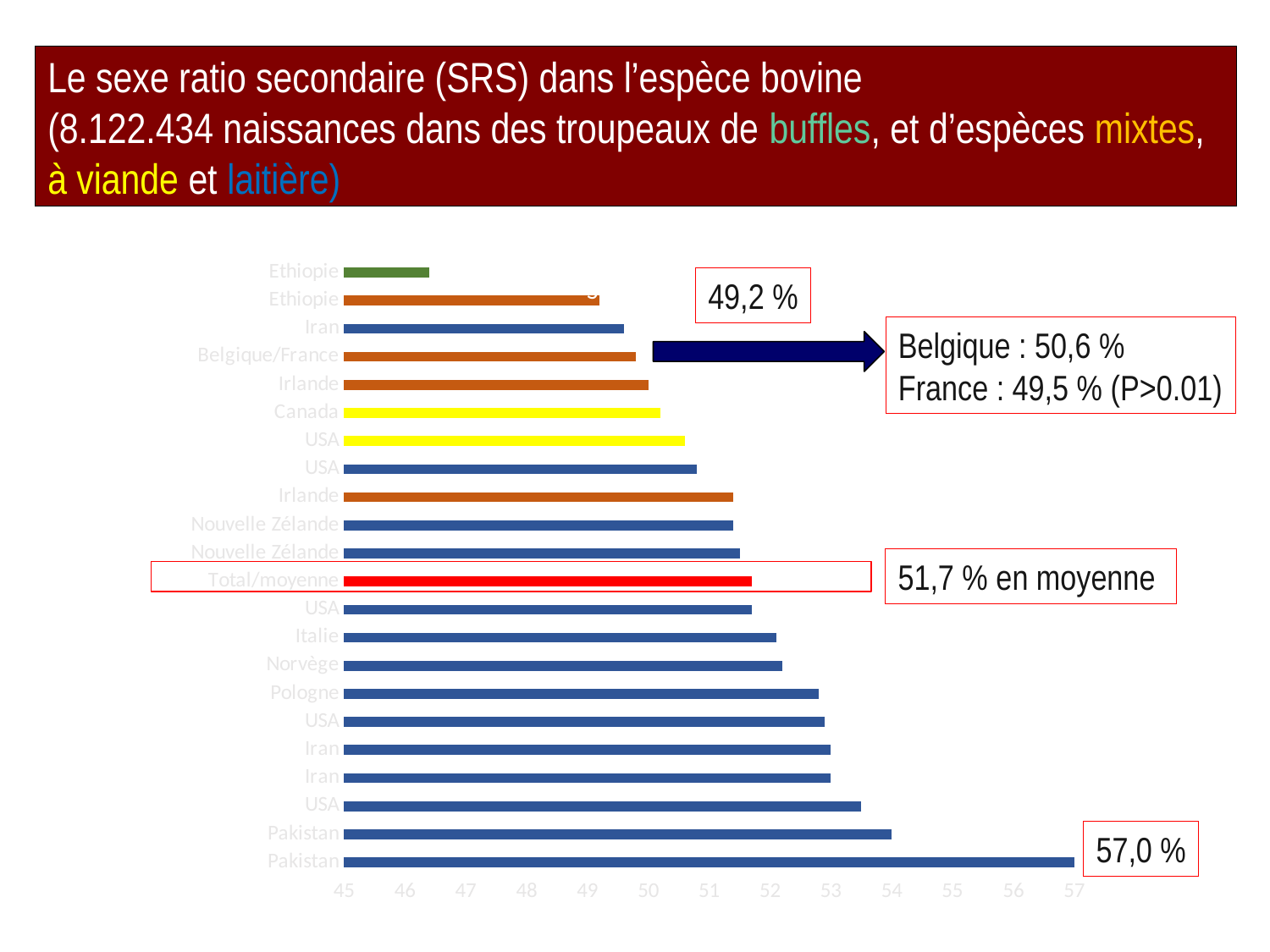
What is the difference between the bottom Pakistan value (57,0 %) and the Total/moyenne value (51,7 %)? 5,3 Is the value for the top Ethiopie bar greater or less than 47? less What kind of chart is shown on the slide? bar chart What is the value shown for the Total/moyenne bar? 51,7 % Which category has the longest bar in the chart? Pakistan (bottom bar) What colour is the Total/moyenne bar? red Is the value for Pologne greater or less than 53? less Which is larger, the value for Total/moyenne or the value for Canada? Total/moyenne How many bars are plotted in the chart? 22 What is the value shown for the bottom Pakistan bar? 57,0 % Is the value for the top Iran bar greater or less than 50? less Which category has the shortest bar in the chart? Ethiopie (top bar)